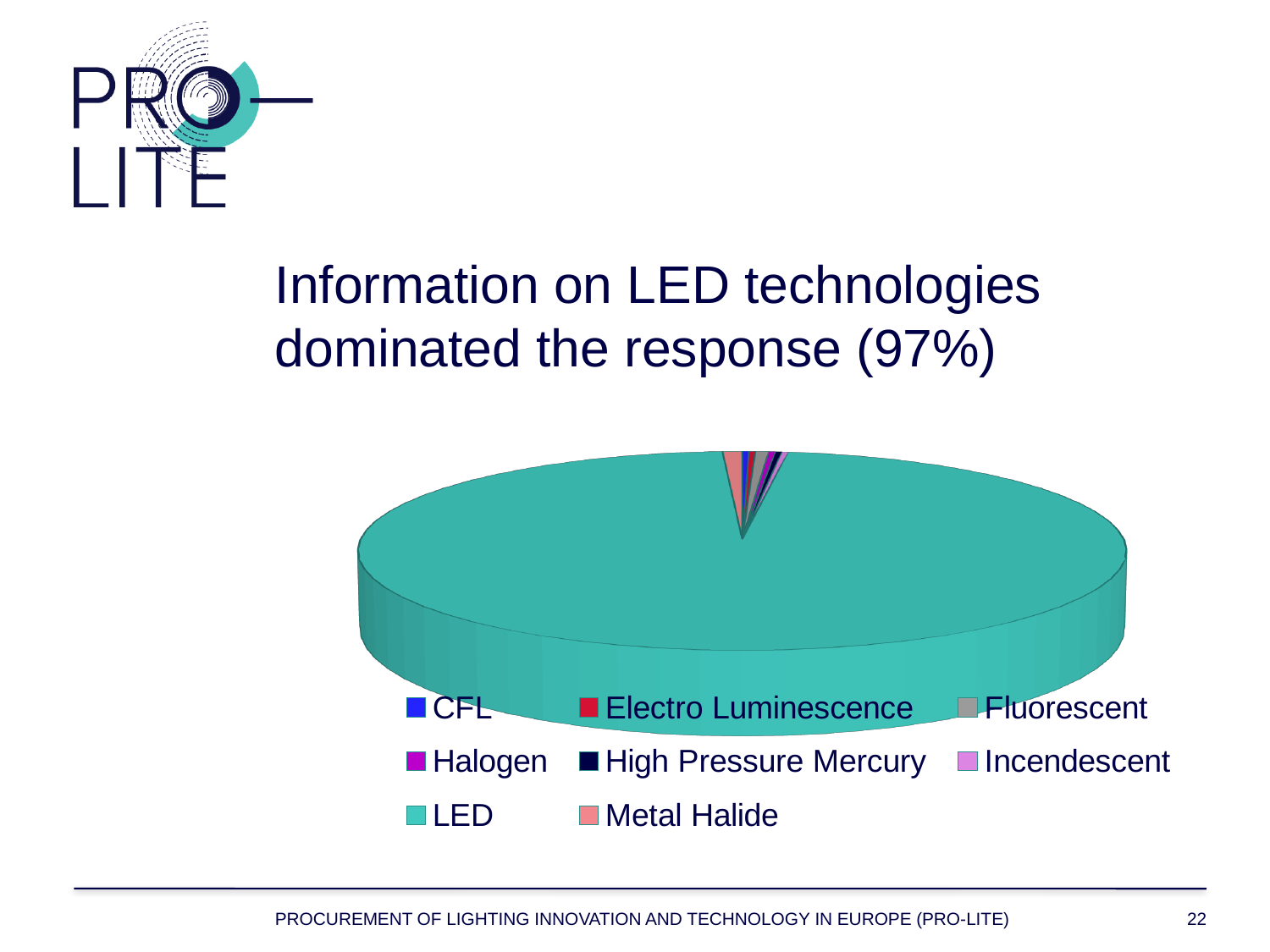
What kind of chart is shown on the slide? pie chart Which is larger in the pie chart, the slice for LED or the slice for CFL? LED Which is larger in the pie chart, the slice for Halogen or the slice for LED? LED Which category has the largest slice of the pie chart? LED What is the title text above the pie chart? Information on LED technologies dominated the response (97%) How many categories does the pie chart's legend list? 8 According to the slide, what share of the response did LED technologies account for? 97% What colour is used for the LED slice in the pie chart? teal